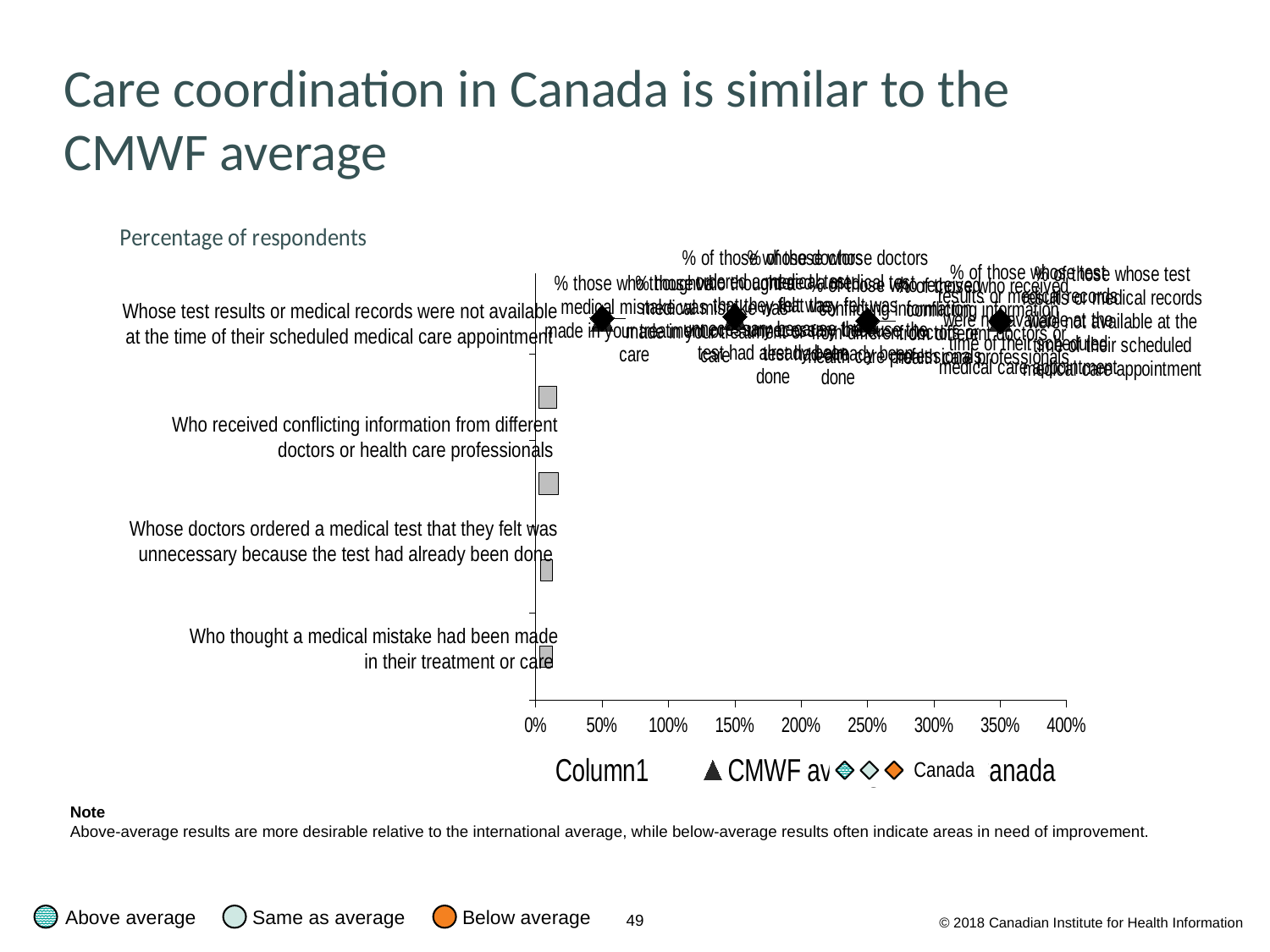
What is the lowest value shown on the horizontal axis of the chart? 0% Is the bar for 'Whose doctors ordered a medical test that they felt was unnecessary because the test had already been done' greater or less than 100%? less Is the bar for 'Who received conflicting information from different doctors or health care professionals' greater or less than 50%? less Is the bar for 'Who thought a medical mistake had been made in their treatment or care' greater or less than 50%? less What is the title of the slide containing the chart? Care coordination in Canada is similar to the CMWF average What is the highest value shown on the horizontal axis of the chart? 400% What kind of chart is shown on the slide? bar chart What does the chart's subtitle say is being measured? Percentage of respondents How many categories are listed on the vertical axis of the chart? 4